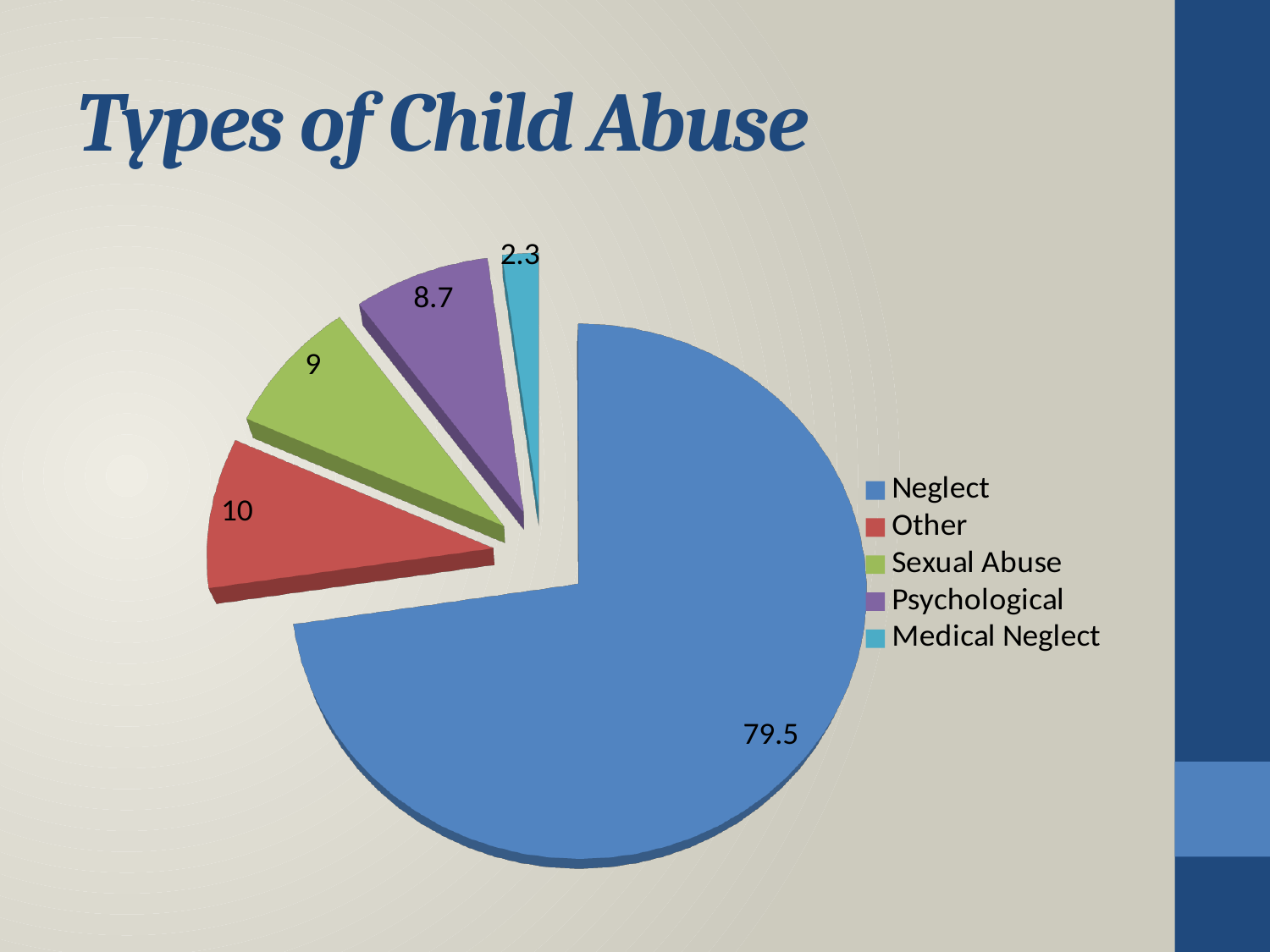
What is the difference between the values for Psychological and Medical Neglect? 6.4 What kind of chart is shown on the slide? Pie chart What is the value for Medical Neglect? 2.3 What is the value for Sexual Abuse? 9 Which category has the smallest slice? Medical Neglect Which is larger, the value for Other or the value for Medical Neglect? Other Which category has the largest slice? Neglect What is the difference between the values for Neglect and Other? 69.5 What is the value for Psychological? 8.7 How many categories does the pie chart show? 5 What is the value for Neglect? 79.5 What is the value for Other? 10